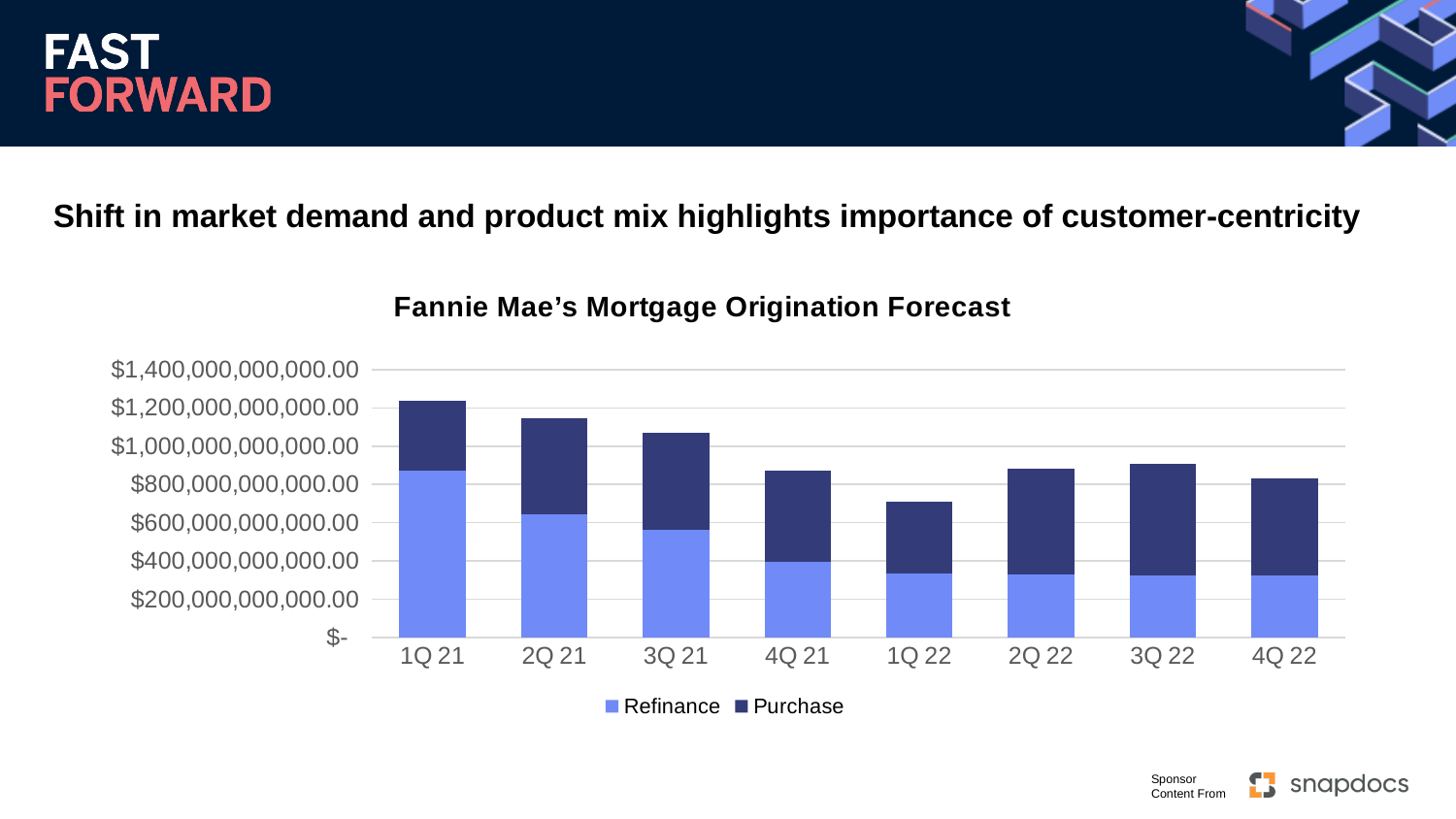
Is the Refinance value for 1Q 21 greater or less than $800,000,000,000.00? greater How many quarters are shown on the x axis? 8 Is the total bar for 1Q 21 greater or less than $1,200,000,000,000.00? greater Does the Refinance series generally rise or fall from 1Q 21 to 4Q 22? fall Which quarter has the shortest total bar? 1Q 22 Which quarter has the tallest total bar? 1Q 21 How many series does the legend list? 2 What is the title of the chart? Fannie Mae's Mortgage Origination Forecast What kind of chart is shown on the slide? stacked bar chart Is the total bar for 1Q 22 greater or less than $800,000,000,000.00? less Which is larger, the Refinance value for 1Q 21 or the Refinance value for 4Q 22? 1Q 21